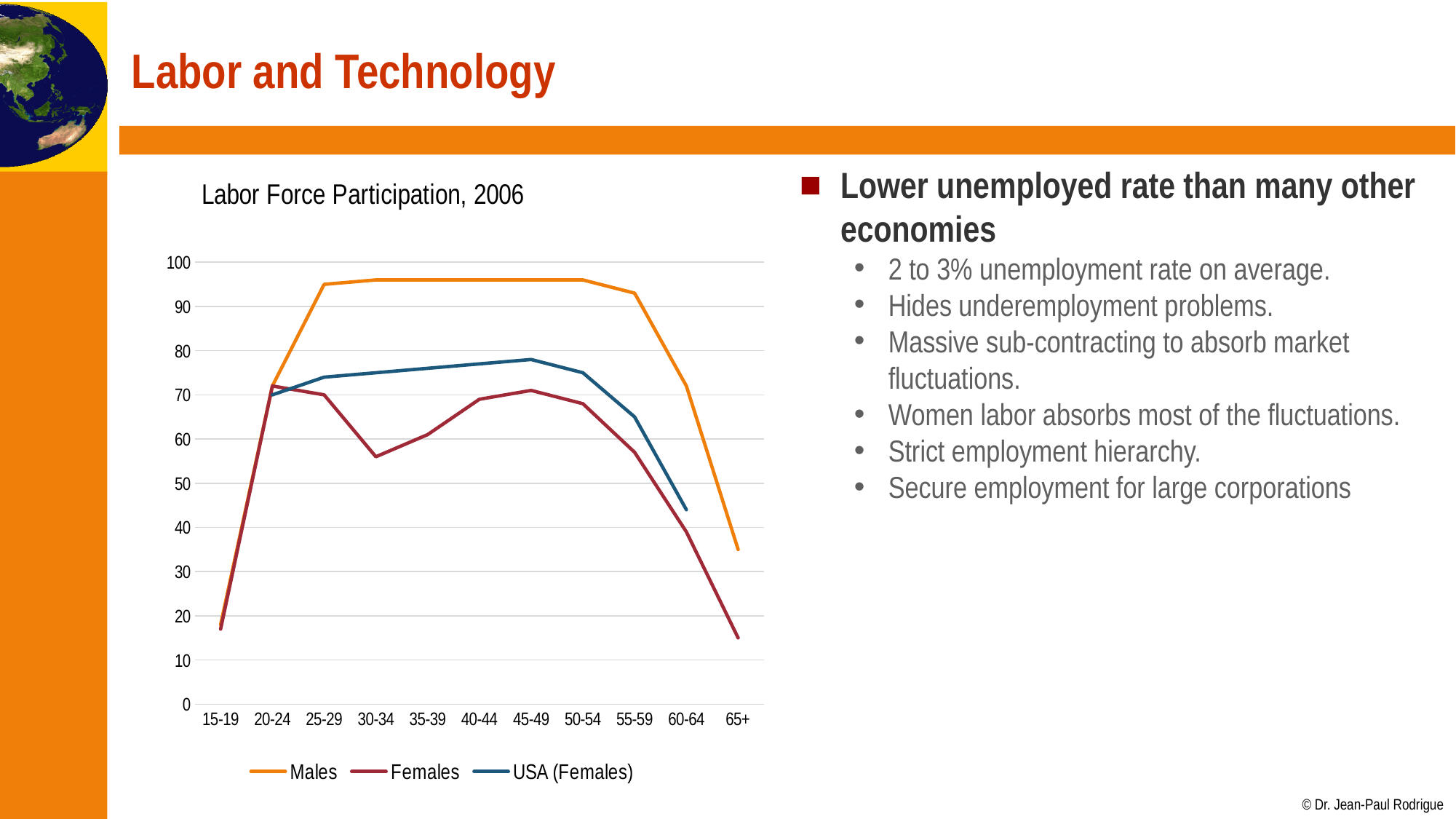
Is the value for Females at 30-34 greater or less than 60? less What kind of chart is shown on the slide? Line chart What is the title of the chart? Labor Force Participation, 2006 How many age-group categories are shown on the x axis? 11 Do the Males values rise or fall from 50-54 to 65+? fall Is the value for Males at 30-34 greater or less than 90? greater At 30-34, which is larger: Males or Females? Males Is the value for USA (Females) at 45-49 greater or less than 70? greater Which age group has the highest value for USA (Females)? 45-49 Which age group has the lowest value for Males? 15-19 How many series does the chart legend list? 3